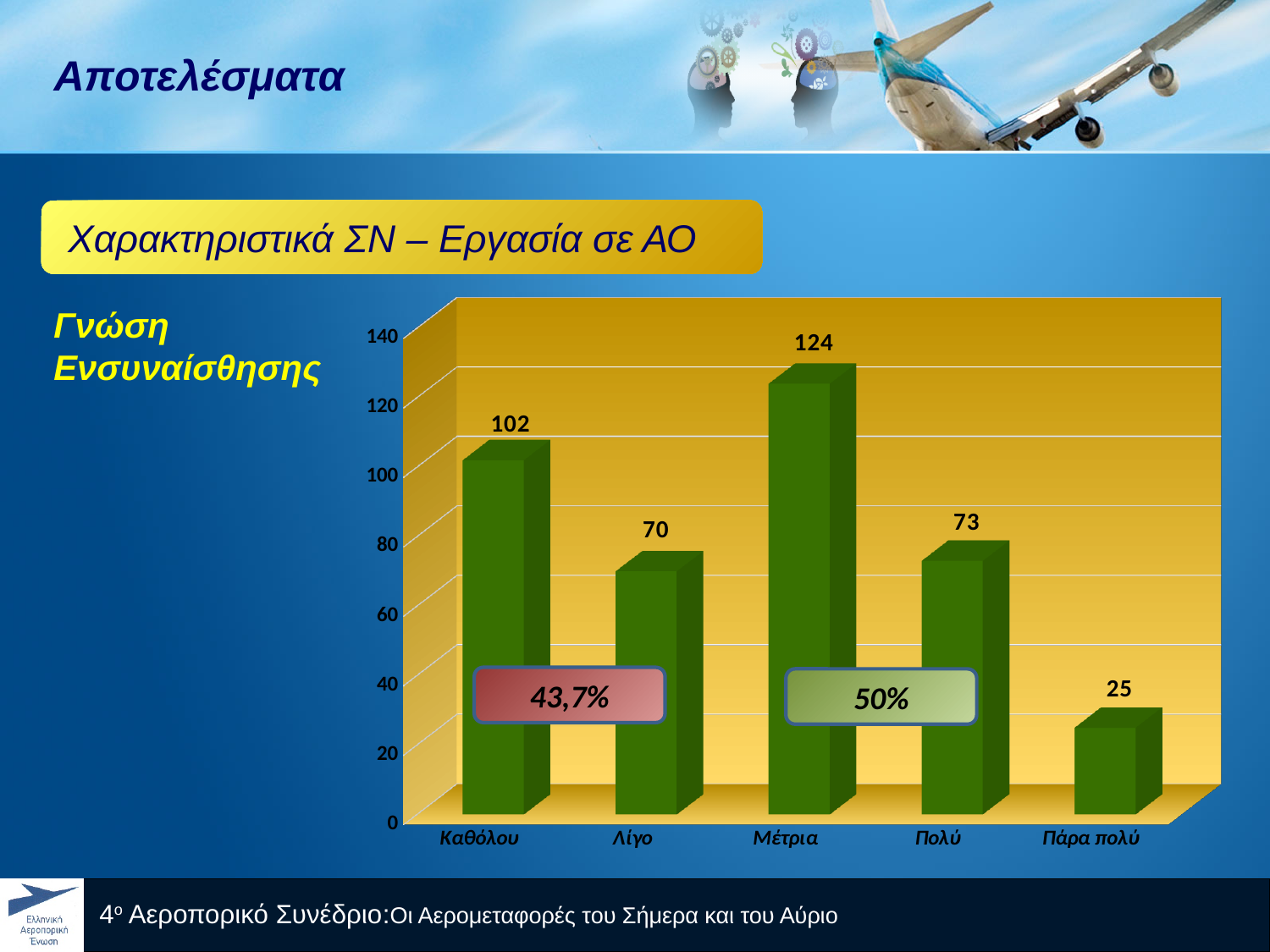
How many categories are shown on the x axis? 5 Which category has the lowest value? Πάρα πολύ What is the value for Πολύ? 73 What kind of chart is shown on the slide? Bar chart What percentage is shown in the red label overlaid on the chart? 43,7% Which is larger, the value for Καθόλου or the value for Πολύ? Καθόλου Which category has the highest value? Μέτρια What is the value for Καθόλου? 102 What is the difference between the values for Μέτρια and Καθόλου? 22 What is the value for Λίγο? 70 What is the value for Μέτρια? 124 What is the value for Πάρα πολύ? 25